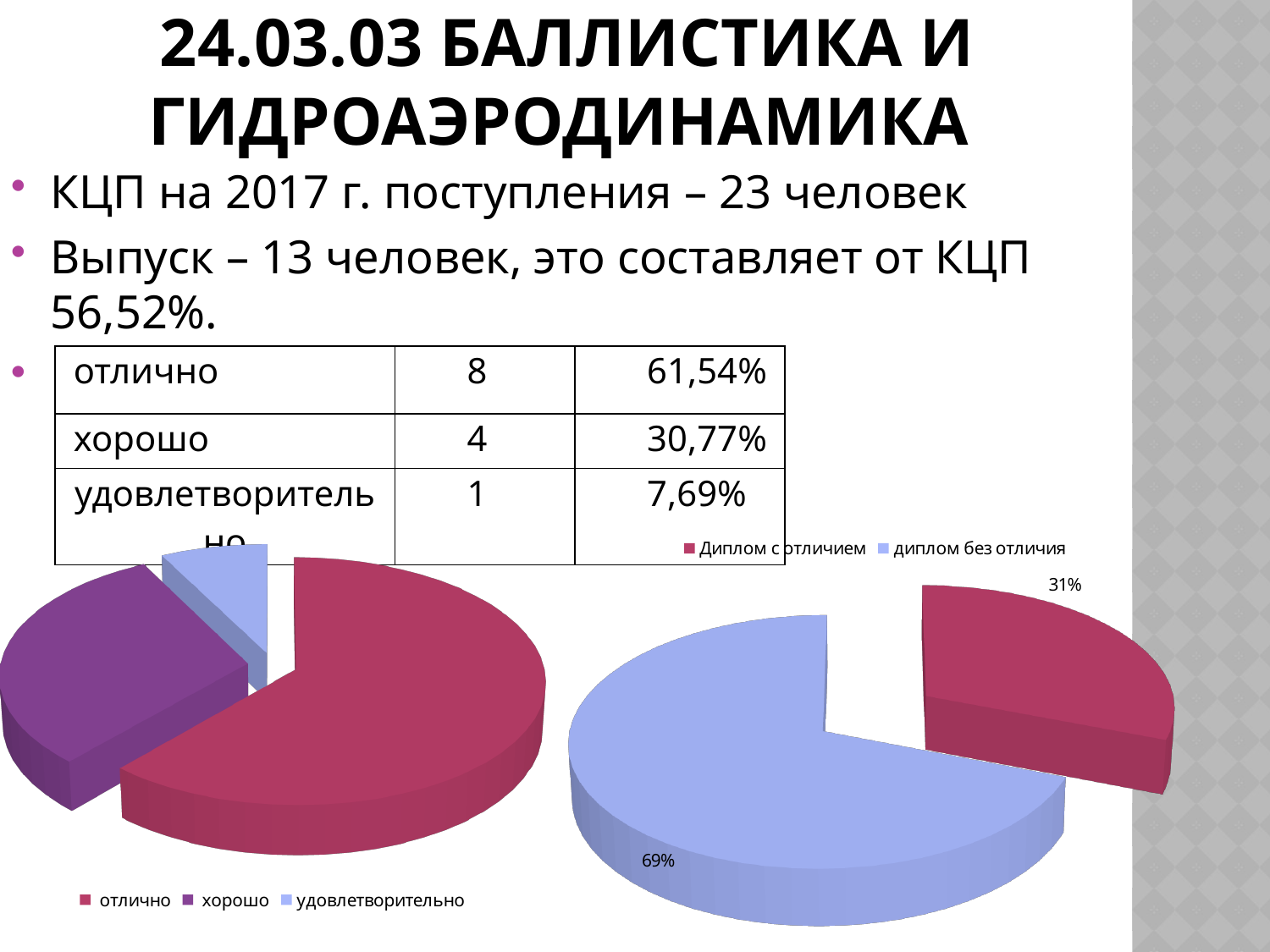
In the left pie chart, which category has the largest slice? отлично In the left pie chart, how many slices are there? 3 What kind of chart is the right chart with the legend Диплом с отличием and диплом без отличия? pie chart In the right pie chart, what share is labelled for Диплом с отличием? 31% In the right pie chart, what is the difference between the shares of диплом без отличия and Диплом с отличием? 38% In the left pie chart, what colour is the slice for отлично? red What kind of chart is the left chart with the legend отлично, хорошо, удовлетворительно? pie chart In the left pie chart, which category has the smallest slice? удовлетворительно In the left pie chart, which slice is larger: хорошо or удовлетворительно? хорошо In the right pie chart, how many slices are there? 2 In the right pie chart, what share is labelled for диплом без отличия? 69% In the right pie chart, which category has the larger slice? диплом без отличия